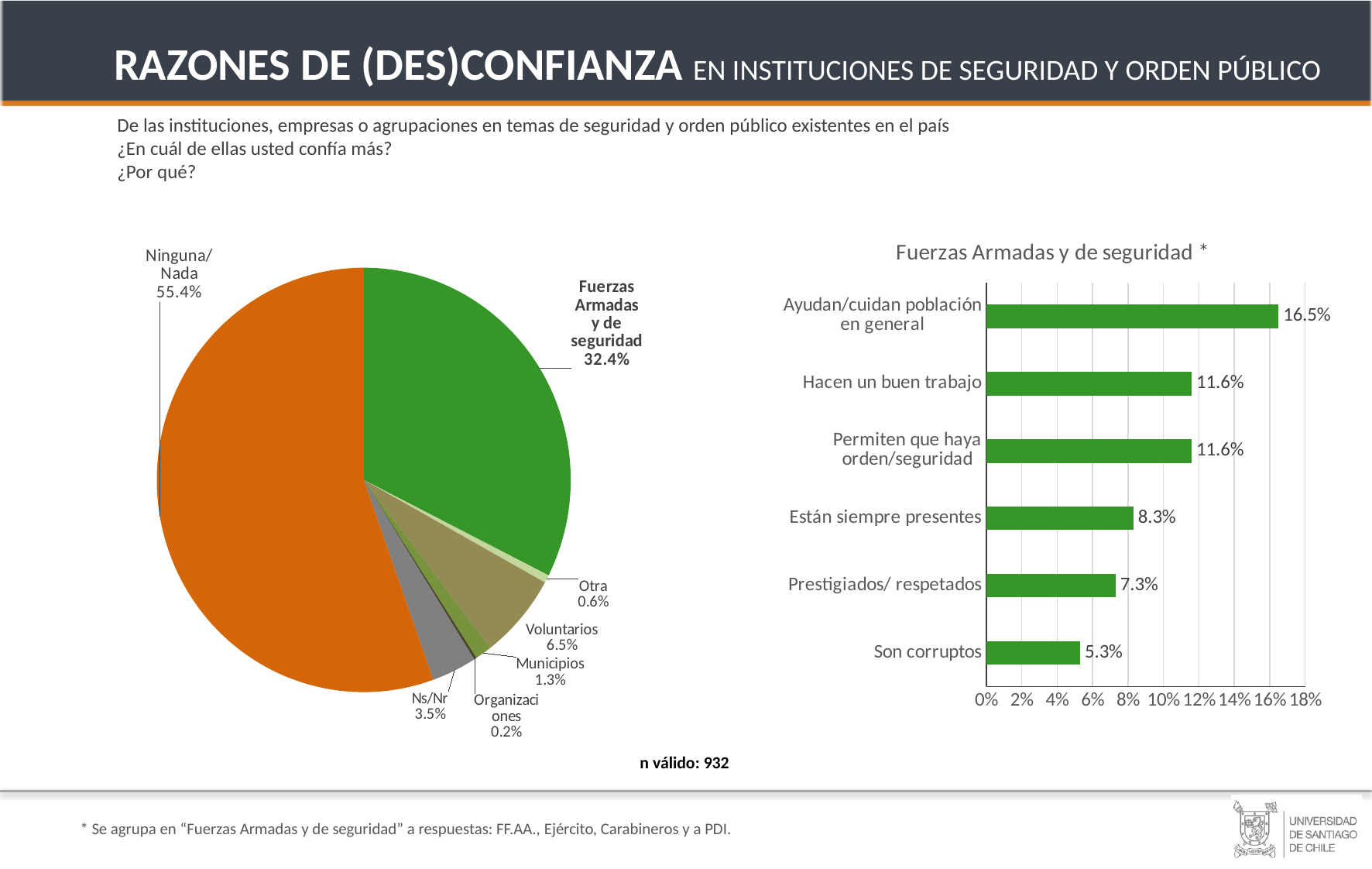
In the pie chart on the left, what is the difference between 'Voluntarios' and 'Ns/Nr'? 3.0% In the bar chart titled 'Fuerzas Armadas y de seguridad *', which is larger: 'Están siempre presentes' or 'Prestigiados/ respetados'? Están siempre presentes In the pie chart on the left, what share does 'Ninguna/ Nada' have? 55.4% In the bar chart titled 'Fuerzas Armadas y de seguridad *', how many categories are shown? 6 In the pie chart on the left, what is the value for 'Fuerzas Armadas y de seguridad'? 32.4% What kind of chart is the one on the right of the slide? Bar chart In the bar chart titled 'Fuerzas Armadas y de seguridad *', what is the difference between 'Ayudan/cuidan población en general' and 'Hacen un buen trabajo'? 4.9% In the bar chart titled 'Fuerzas Armadas y de seguridad *', which category has the lowest value? Son corruptos In the pie chart on the left, which category has the smallest slice? Organizaciones In the bar chart titled 'Fuerzas Armadas y de seguridad *', what is the value for 'Ayudan/cuidan población en general'? 16.5% In the pie chart on the left, which category has the largest slice? Ninguna/ Nada In the pie chart on the left, how many categories are shown? 7